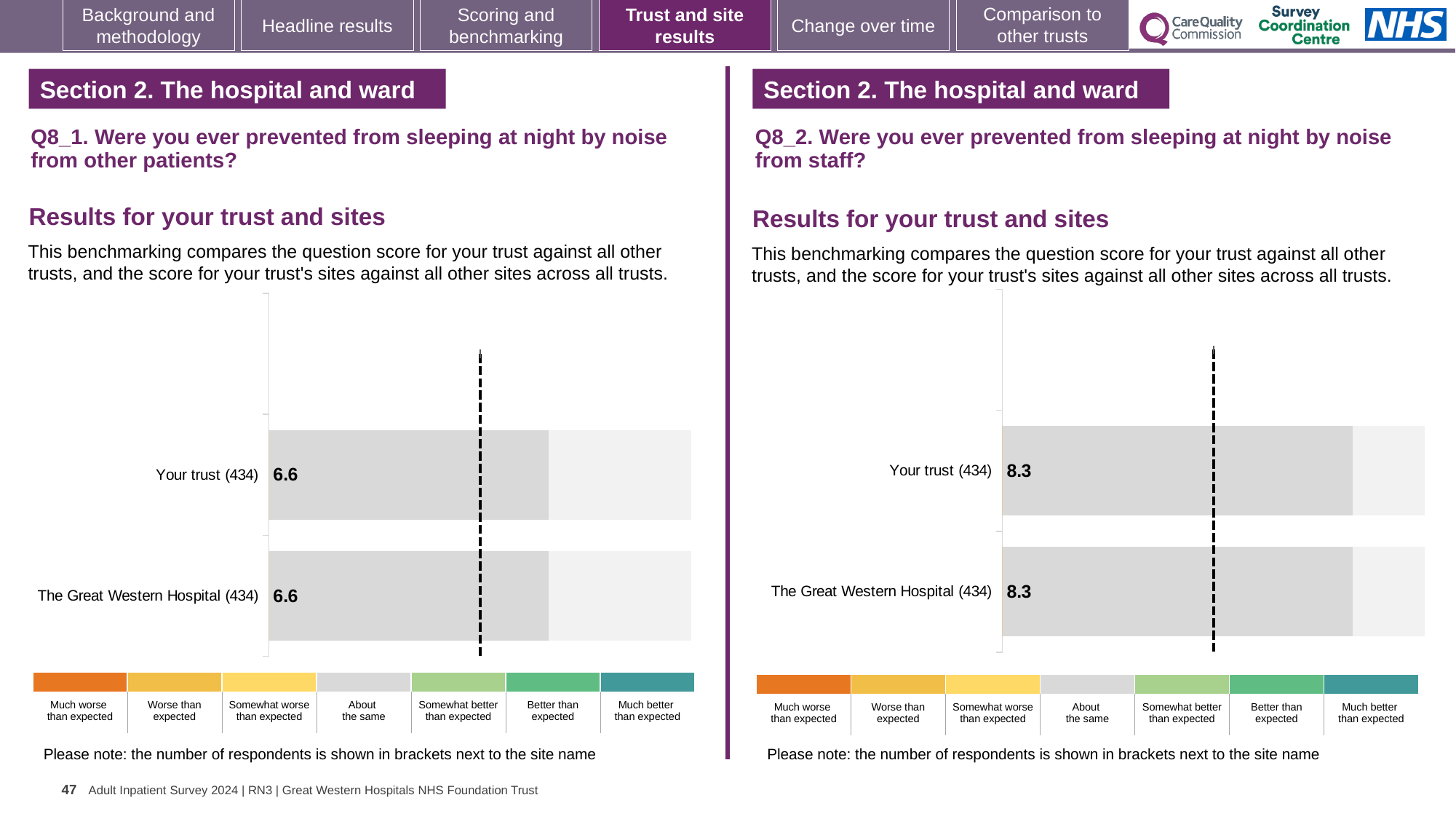
In the Q8_2 chart (noise from staff), what is the score for Your trust (434)? 8.3 How many benchmark categories does the colour legend below the Q8_2 chart list? 7 In the Q8_2 chart (noise from staff), what is the score for The Great Western Hospital (434)? 8.3 In the Q8_1 chart (noise from other patients), what is the difference between the score for Your trust and the score for The Great Western Hospital? 0.0 How many respondents are shown in brackets for The Great Western Hospital in the Q8_1 chart? 434 Is the score for Your trust in the Q8_2 chart (noise from staff) larger than the score for Your trust in the Q8_1 chart (noise from other patients)? Yes In the Q8_1 chart (noise from other patients), what is the score for Your trust (434)? 6.6 What kind of chart is used for the Q8_1 results (noise from other patients)? Bar chart How many bars are plotted in the Q8_2 chart (noise from staff)? 2 In the Q8_2 chart (noise from staff), what is the difference between the score for Your trust and the score for The Great Western Hospital? 0.0 How many bars are plotted in the Q8_1 chart (noise from other patients)? 2 In the Q8_1 chart (noise from other patients), what is the score for The Great Western Hospital (434)? 6.6